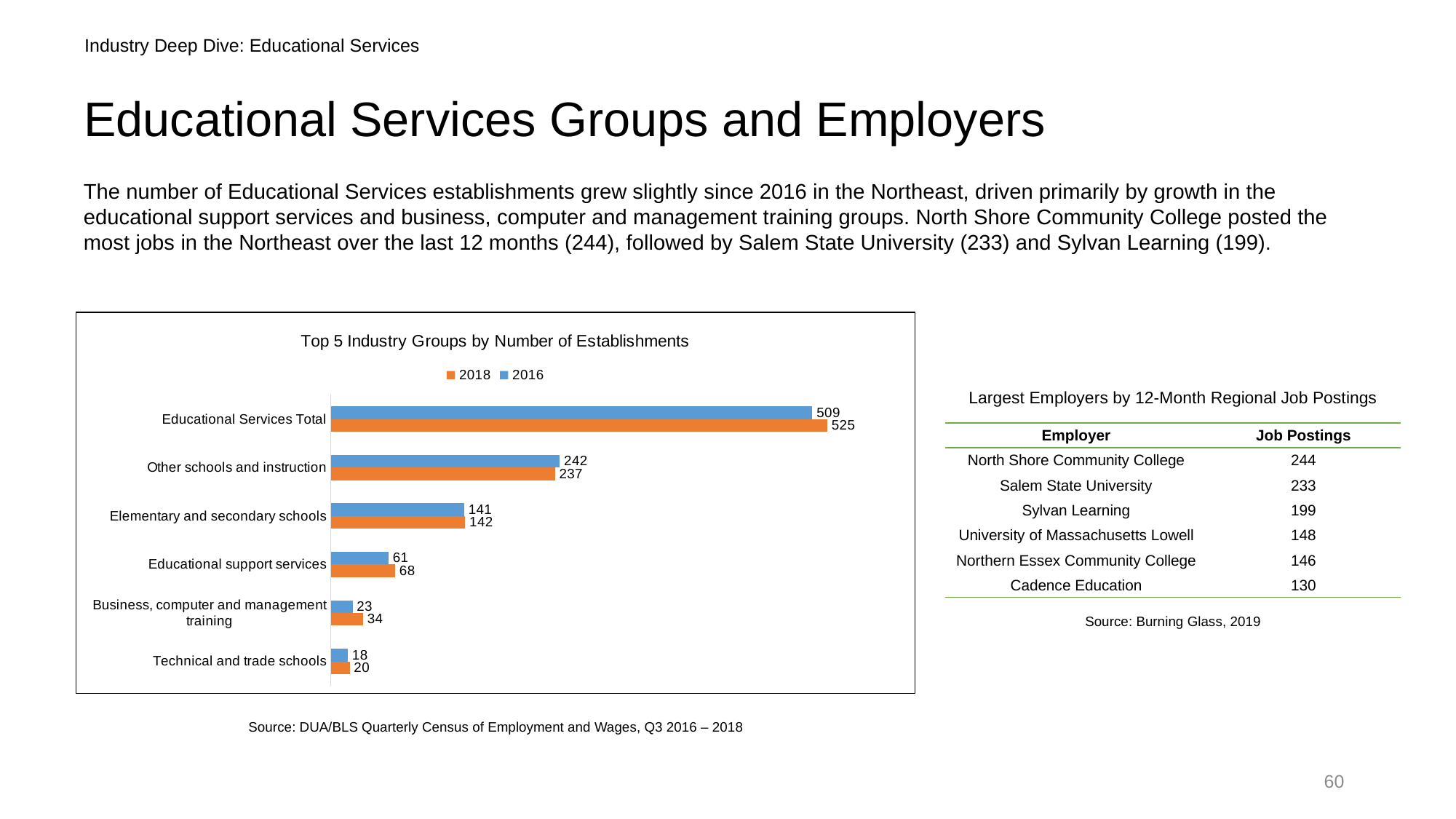
Which category has the lowest 2018 value? Technical and trade schools What is the difference between the 2018 and 2016 values for Business, computer and management training? 11 Which colour represents the 2018 series in the chart? Orange What is the difference between the 2018 and 2016 values for Educational Services Total? 16 What is the 2018 value for Educational support services? 68 What is the 2016 value for Other schools and instruction? 242 What is the 2016 value for Business, computer and management training? 23 How many series does the legend of the "Top 5 Industry Groups by Number of Establishments" chart list? 2 What is the 2018 value for Educational Services Total? 525 How many categories are shown on the "Top 5 Industry Groups by Number of Establishments" chart? 6 For Other schools and instruction, which is larger: the 2016 value or the 2018 value? 2016 What type of chart is "Top 5 Industry Groups by Number of Establishments"? Bar chart